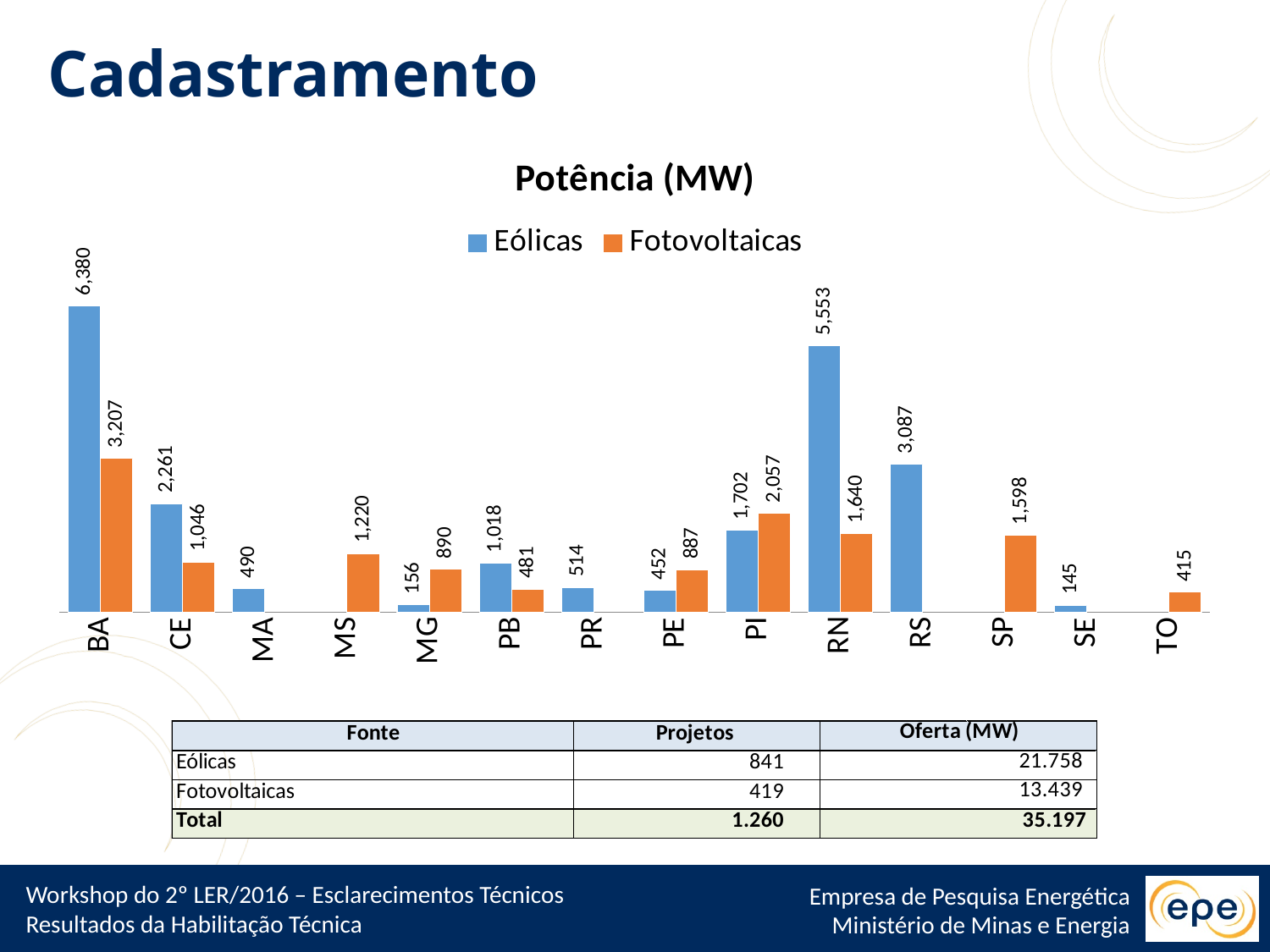
What is the difference between the Eólicas and Fotovoltaicas values for RN? 3,913 For MG, which is larger: Eólicas or Fotovoltaicas? Fotovoltaicas What kind of chart is shown? Bar chart Which state has the highest Fotovoltaicas value? BA Which state has the lowest Eólicas value? SE How many series does the legend list? 2 What is the Eólicas value for RS? 3,087 What is the Fotovoltaicas value for SP? 1,598 What is the Fotovoltaicas value for PI? 2,057 Which state has the highest Eólicas value? BA What is the Eólicas value for BA? 6,380 How many states are shown on the x axis? 14